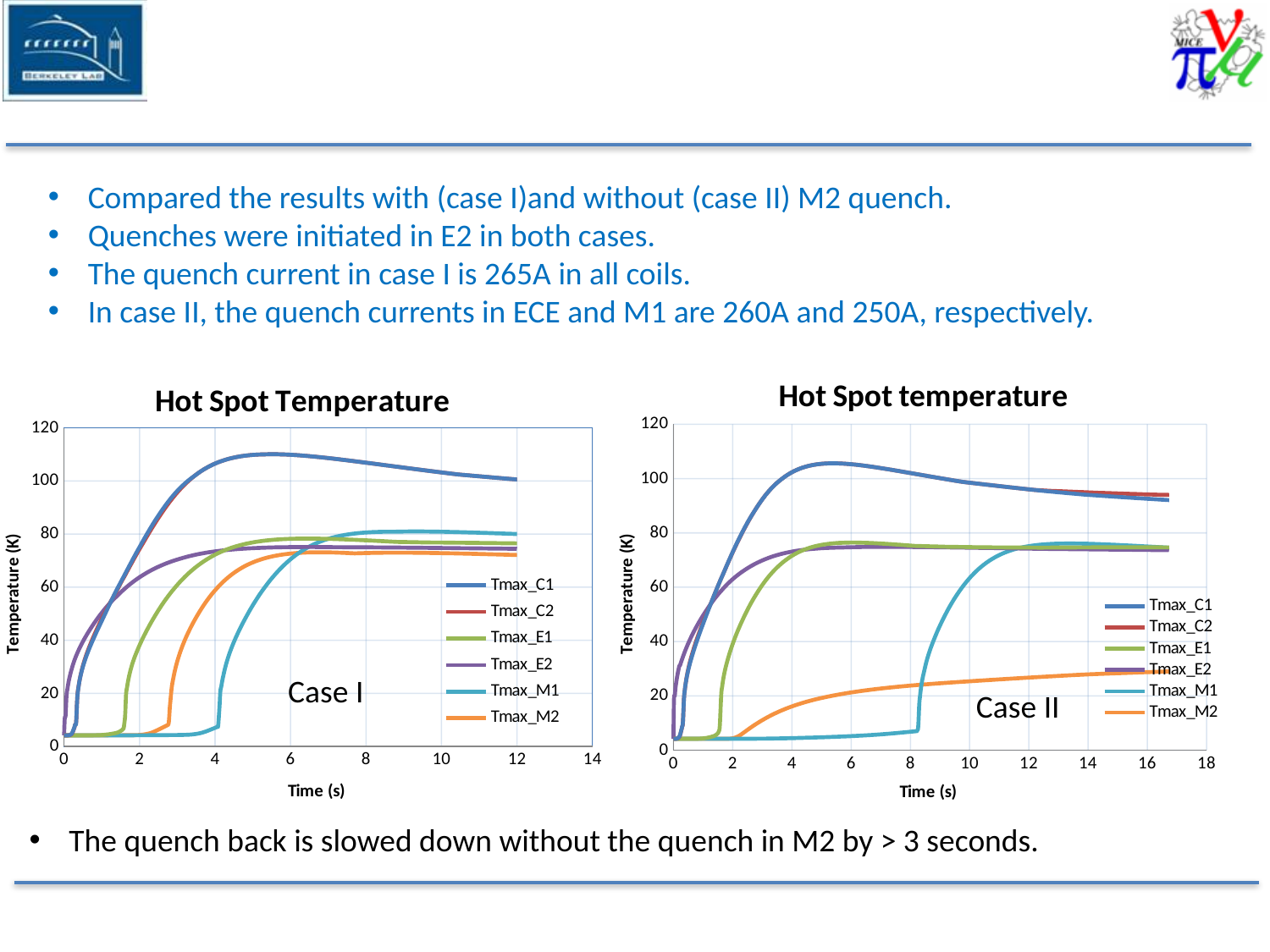
In the right chart (Case II), does the Tmax_M2 curve rise or fall as time increases? rise In the left chart (Case I), is the value of Tmax_M1 at time 4 s greater or less than 20? less In the right chart (Case II), which series has the lowest temperature at the end of the time range? Tmax_M2 What kind of chart is the left chart titled "Hot Spot Temperature" (Case I)? line chart What is the label of the y axis on the right chart (Case II)? Temperature (K) What is the label of the x axis on the left chart (Case I)? Time (s) How many series does the legend of the right chart (Case II) list? 6 In the right chart (Case II), is the value of Tmax_M2 at the end of the curve greater or less than 40? less In the left chart (Case I), is the peak value of Tmax_C1 greater or less than 100? greater How many series does the legend of the left chart (Case I) list? 6 In the left chart (Case I), which is larger at time 12 s, Tmax_C1 or Tmax_E2? Tmax_C1